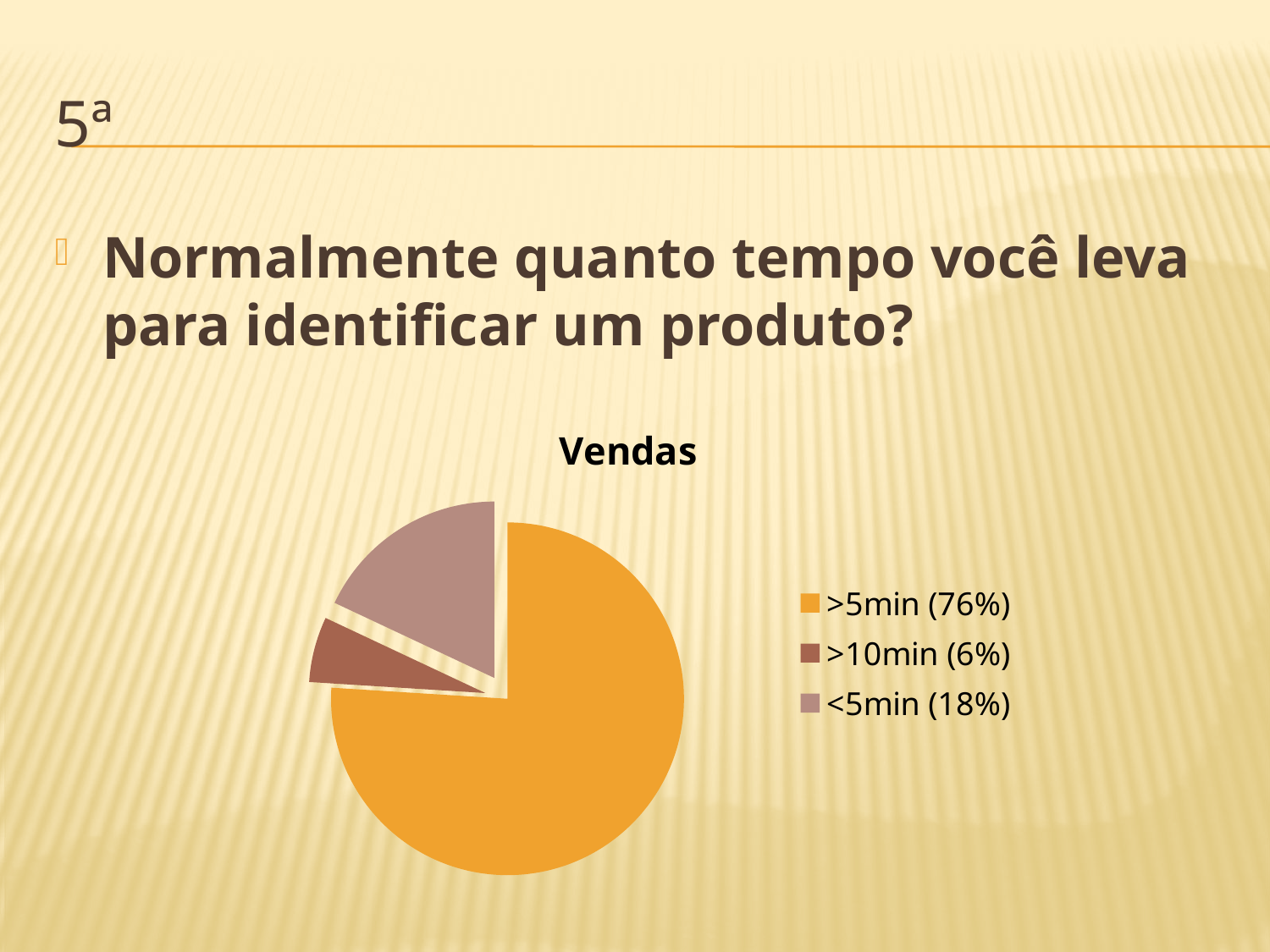
What is the title of the chart? Vendas Which category has the smallest slice of the pie? >10min What is the difference in percentage points between the "<5min" and ">10min" slices? 12 How many slices does the pie chart have? 3 What share of the pie does the "<5min" slice represent? 18% Which category has the largest slice of the pie? >5min What share of the pie does the ">5min" slice represent? 76% What is the difference in percentage points between the ">5min" and "<5min" slices? 58 What share of the pie does the ">10min" slice represent? 6% What colour is the ">5min" slice in the pie chart? orange What kind of chart is shown on the slide? pie chart Which is larger, the "<5min" slice or the ">10min" slice? <5min